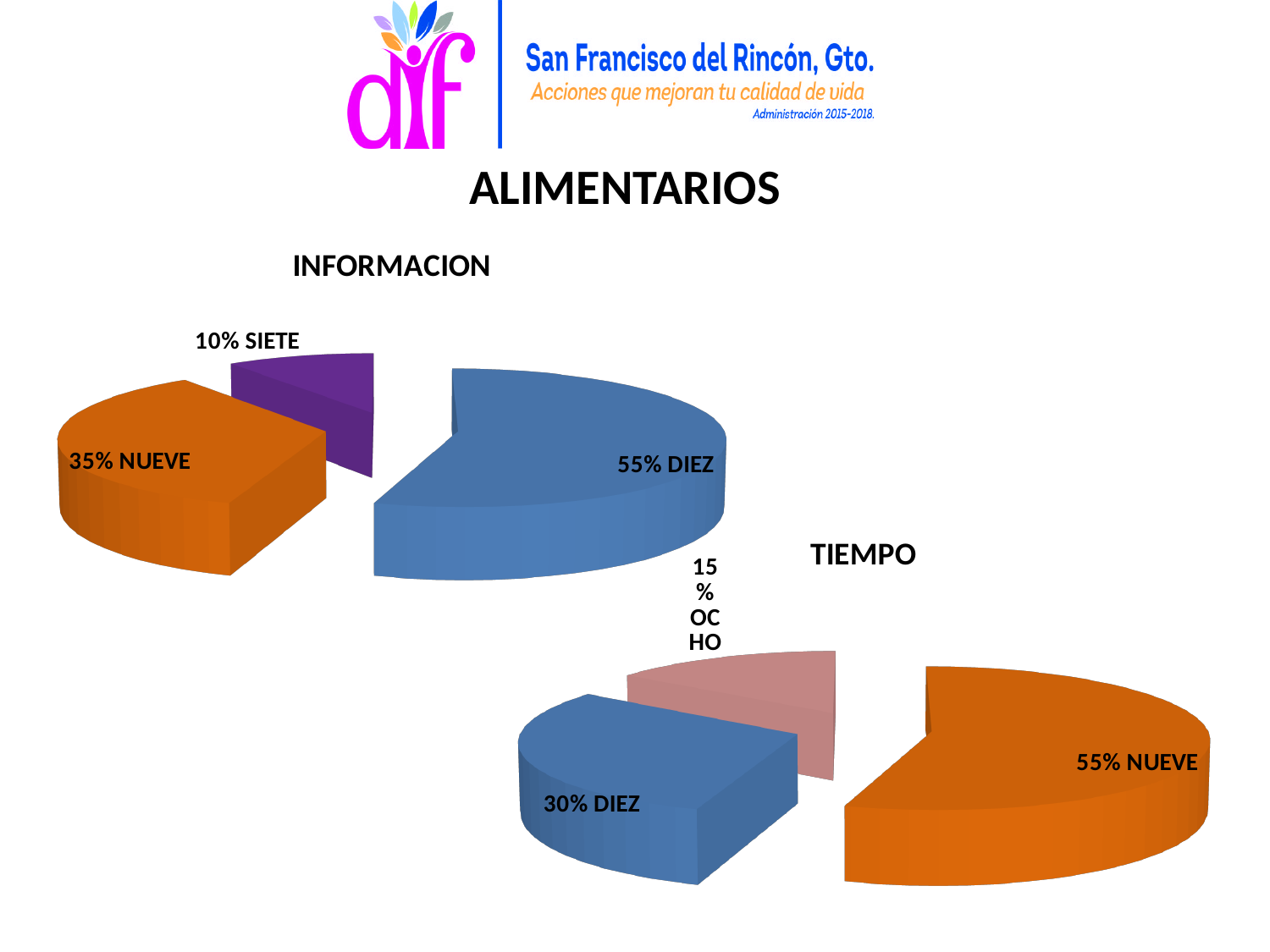
In the TIEMPO chart, what share does the DIEZ slice have? 30% What is the title of the chart at the top left of the slide? INFORMACION In the INFORMACION chart, which category has the largest slice? DIEZ In the TIEMPO chart, which category has the largest slice? NUEVE In the INFORMACION chart, how many slices are there? 3 In the INFORMACION chart, what share does the NUEVE slice have? 35% In the INFORMACION chart, what share does the DIEZ slice have? 55% In the INFORMACION chart, what is the difference in percentage points between DIEZ and NUEVE? 20 In the INFORMACION chart, which category has the smallest slice? SIETE In the TIEMPO chart, which is larger, DIEZ or OCHO? DIEZ What kind of chart is the TIEMPO chart? Pie chart